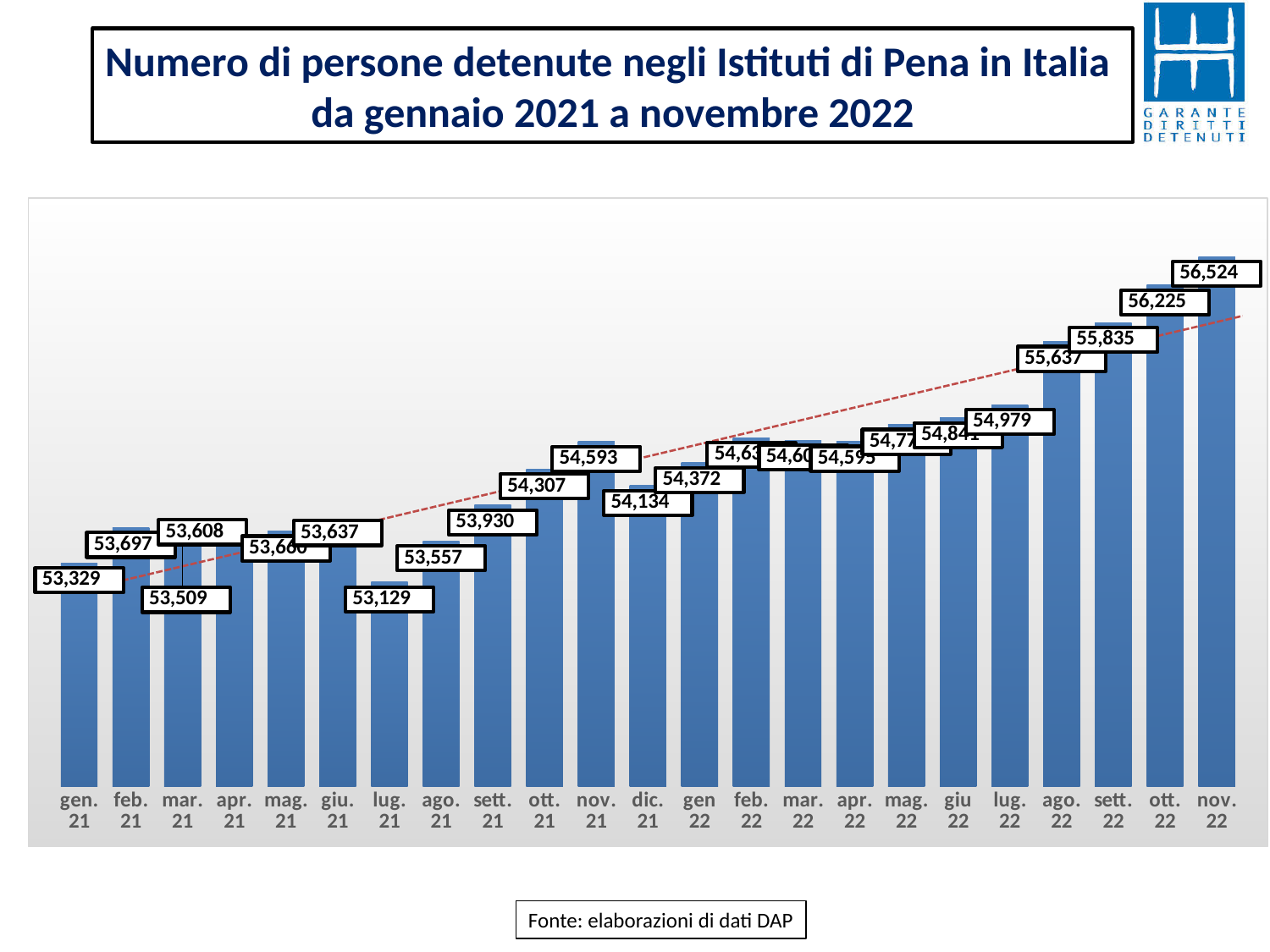
What kind of chart is shown on the slide? Bar chart What is the value for nov. 22? 56,524 What is the difference between the values for nov. 22 and ott. 22? 299 What is the value for lug. 21? 53,129 Which month has the lowest number of detained persons? lug. 21 Which is larger, the value for nov. 21 or the value for dic. 21? nov. 21 What is the value for gen. 21? 53,329 How many months (bars) are plotted in the chart? 23 What is the value for sett. 22? 55,835 Overall, do the values rise or fall from gen. 21 to nov. 22? Rise Which month has the highest number of detained persons? nov. 22 By how much did the number of detained persons increase from gen. 21 to nov. 22? 3,195